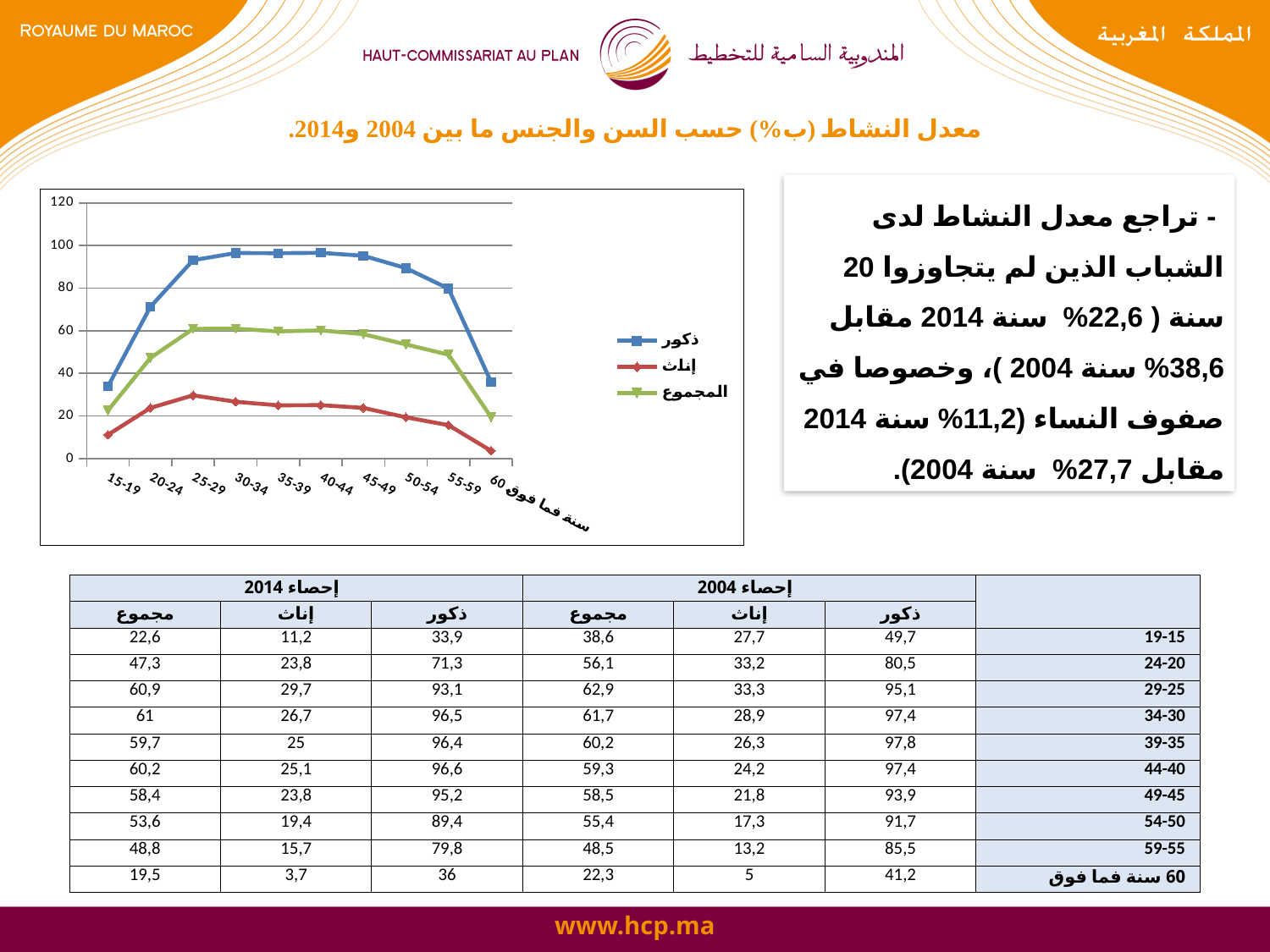
At 30-34, which series has the larger value, ذكور or إناث? ذكور How many series does the chart's legend list? 3 Which series in the chart has the highest values across all age groups? ذكور Is the value of the ذكور series for 15-19 greater or less than 40? less For the إناث series, which age group has the lowest value? 60 سنة فما فوق Is the value of the المجموع series for 25-29 greater or less than 40? greater What colour is the line for the ذكور series in the chart? blue How many age-group categories are plotted along the x axis of the chart? 10 Is the value of the إناث series for 25-29 greater or less than 40? less What kind of chart is shown on the slide? line chart Does the ذكور series rise or fall from 15-19 to 25-29? rise